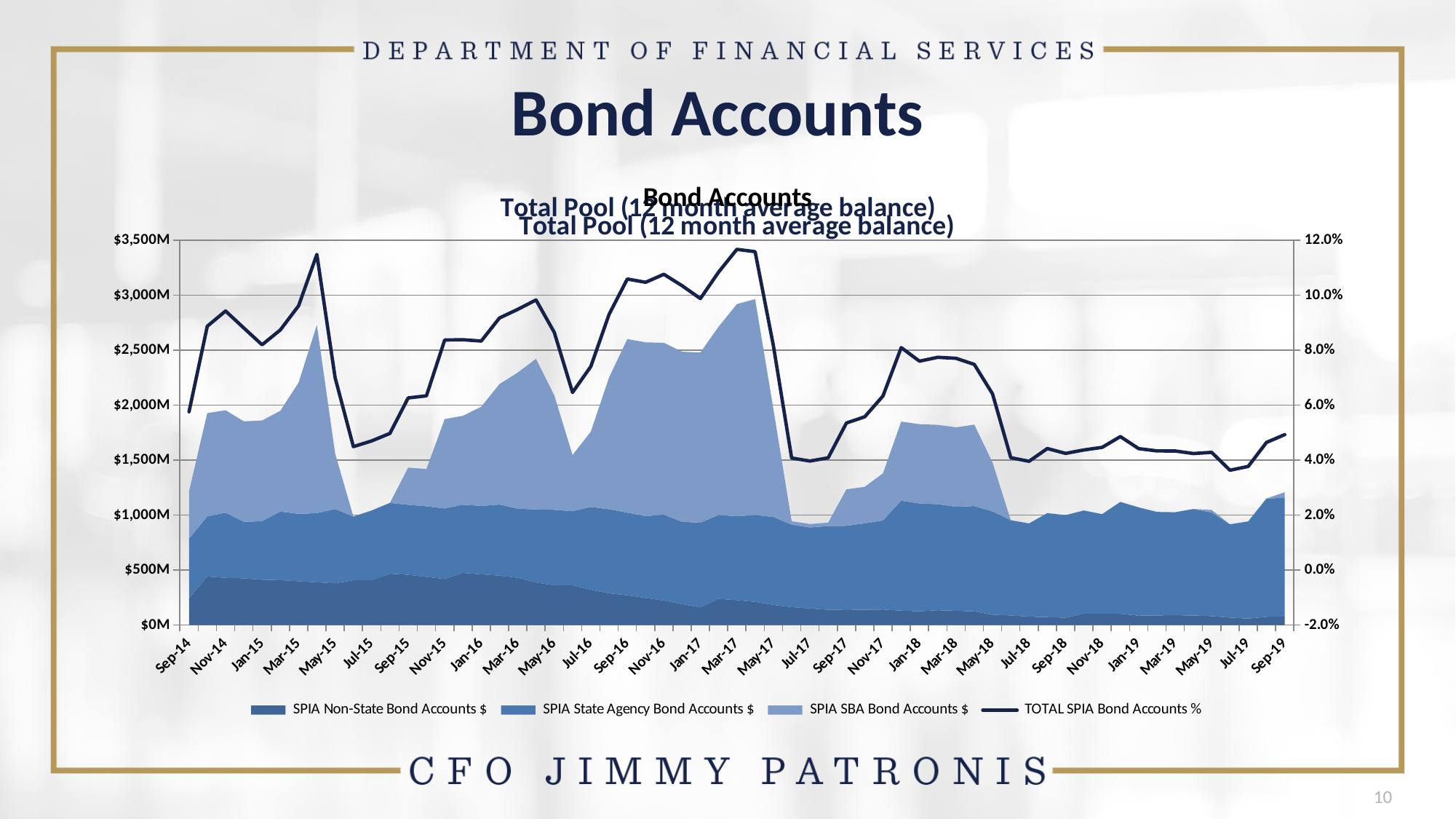
Is the TOTAL SPIA Bond Accounts % value at Mar-17 greater or less than 10.0%? greater Is the TOTAL SPIA Bond Accounts % value at Sep-14 greater or less than 4.0%? greater Does the TOTAL SPIA Bond Accounts % line rise or fall between Mar-17 and Jul-17? fall Is the total stacked balance at Mar-17 greater or less than $2,500M? greater What is the highest value shown on the right-hand percentage axis? 12.0% Which series is plotted as a line rather than a filled area? TOTAL SPIA Bond Accounts % What kind of chart is shown on the slide? combination area and line chart (stacked areas with a line) How many series does the chart legend list? 4 Does the TOTAL SPIA Bond Accounts % line rise or fall between Jan-18 and Jul-18? fall